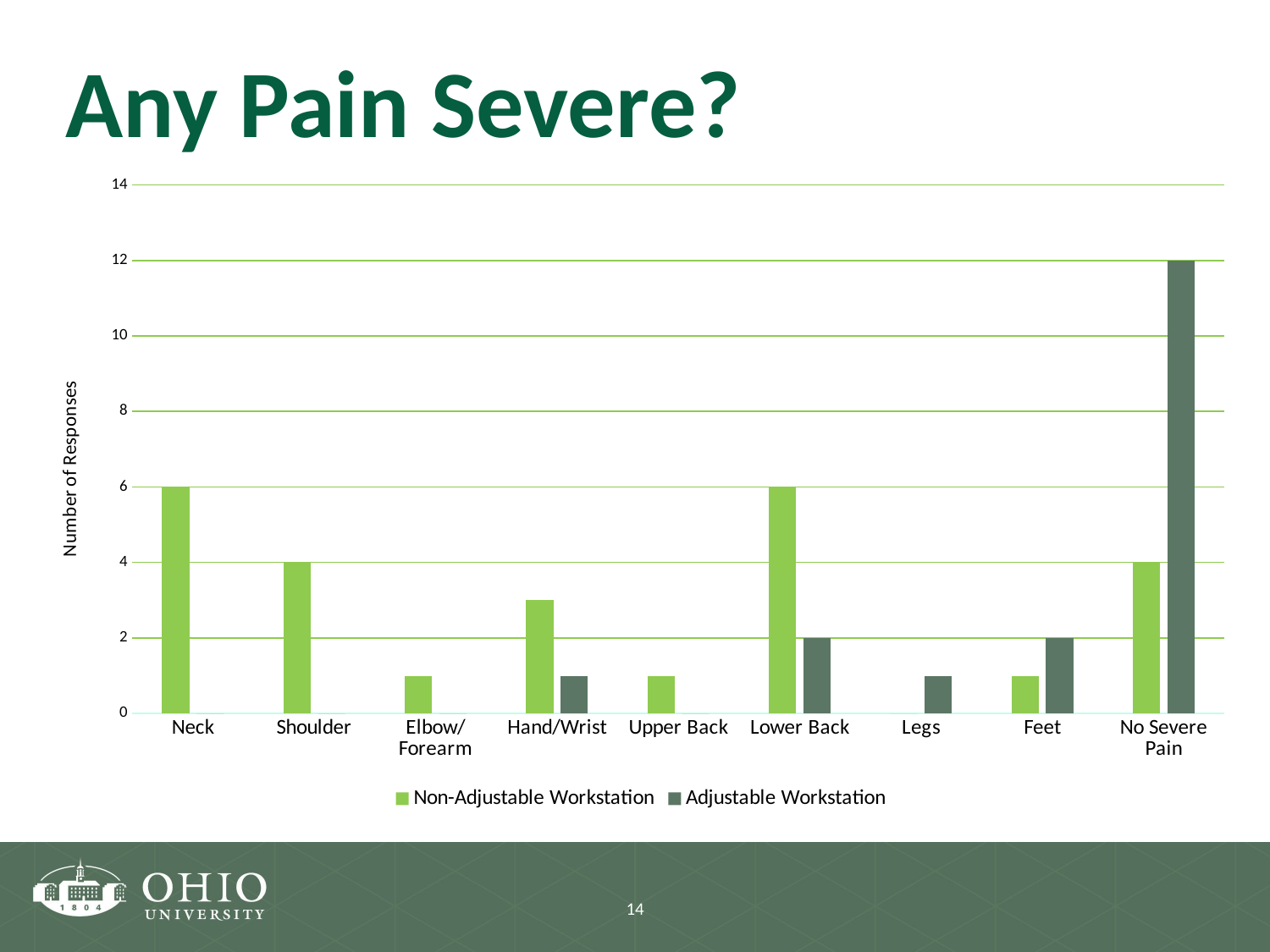
Is the Non-Adjustable Workstation value for Hand/Wrist greater or less than 2? greater What is the label of the y axis? Number of Responses What is the difference between the Adjustable Workstation and Non-Adjustable Workstation values for No Severe Pain? 8 How many categories are shown on the x axis? 9 What is the number of responses for Shoulder in the Non-Adjustable Workstation series? 4 Which category has the highest bar in the Adjustable Workstation series? No Severe Pain What type of chart is shown on the slide? bar chart How many series does the legend list? 2 What is the number of responses for No Severe Pain in the Adjustable Workstation series? 12 Which is larger in the Non-Adjustable Workstation series: Neck or Shoulder? Neck What is the number of responses for Neck in the Non-Adjustable Workstation series? 6 What is the number of responses for Lower Back in the Adjustable Workstation series? 2